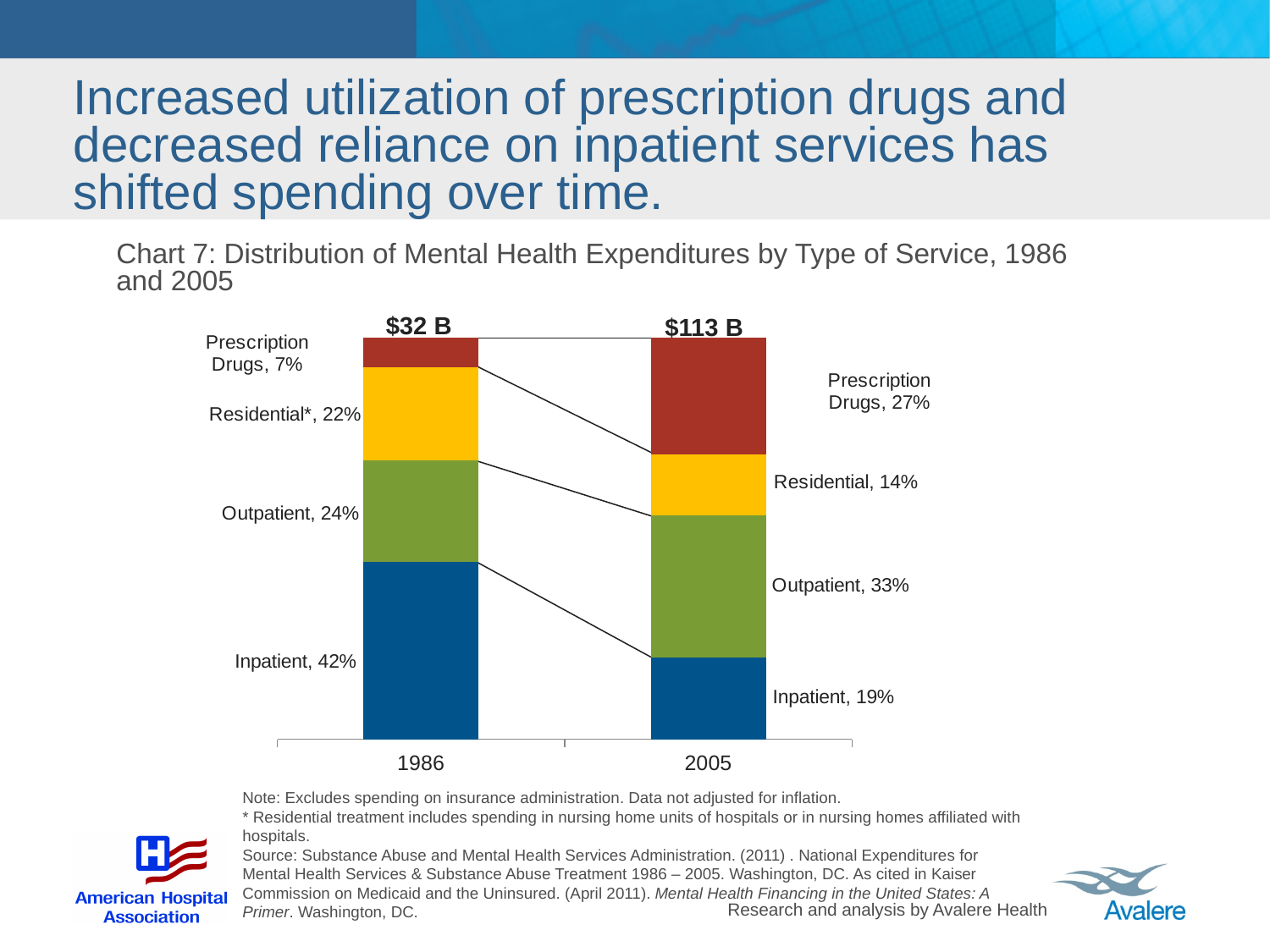
What share of mental health expenditures went to Outpatient services in 2005? 33% What share of mental health expenditures went to Inpatient services in 1986? 42% Which was larger in 2005: the Outpatient share or the Prescription Drugs share? Outpatient How many years (bars) are shown on the x axis? 2 Did the Prescription Drugs share rise or fall from 1986 to 2005? Rise What was the total mental health expenditure shown for 2005? $113 B What share of mental health expenditures went to Prescription Drugs in 2005? 27% By how many percentage points did the Inpatient share fall from 1986 to 2005? 23 percentage points Which type of service had the smallest share of spending in 2005? Residential What share of mental health expenditures went to Residential treatment in 1986? 22% Which type of service had the largest share of spending in 1986? Inpatient What kind of chart is shown? Stacked bar chart